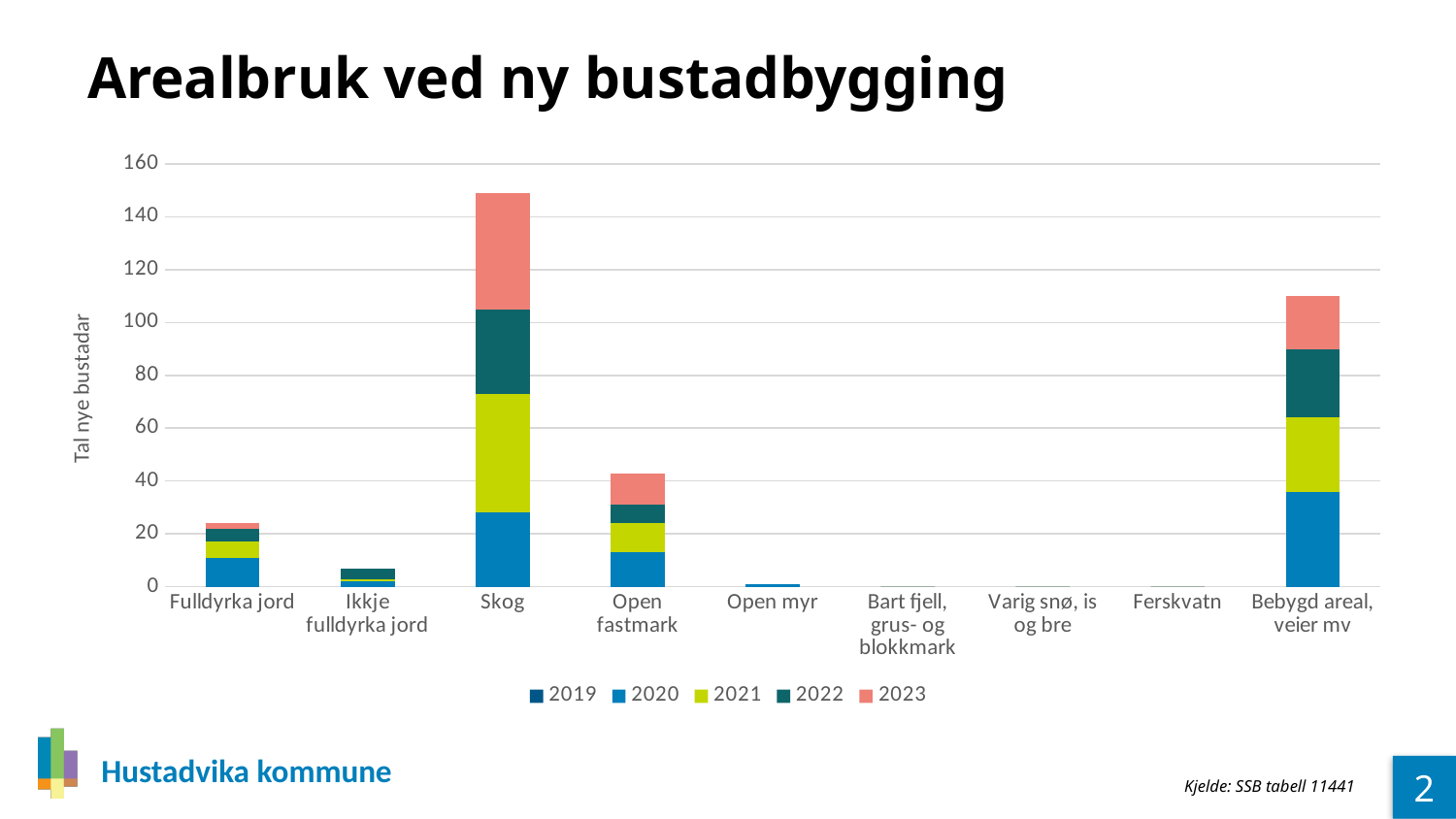
Is the total stacked value for Open fastmark greater or less than 60? less How many series does the chart's legend list? 5 Is the total stacked value for Bebygd areal, veier mv greater or less than 100? greater Is the total stacked value for Skog greater or less than 140? greater Which has the larger total stacked bar: Skog or Bebygd areal, veier mv? Skog What is the label of the chart's vertical axis? Tal nye bustadar Which has the larger total stacked bar: Open fastmark or Fulldyrka jord? Open fastmark How many categories are shown along the x axis of the chart? 9 Which category has the tallest stacked bar in the chart? Skog What is the title of the chart on the slide? Arealbruk ved ny bustadbygging What kind of chart is shown on the slide? Stacked bar chart